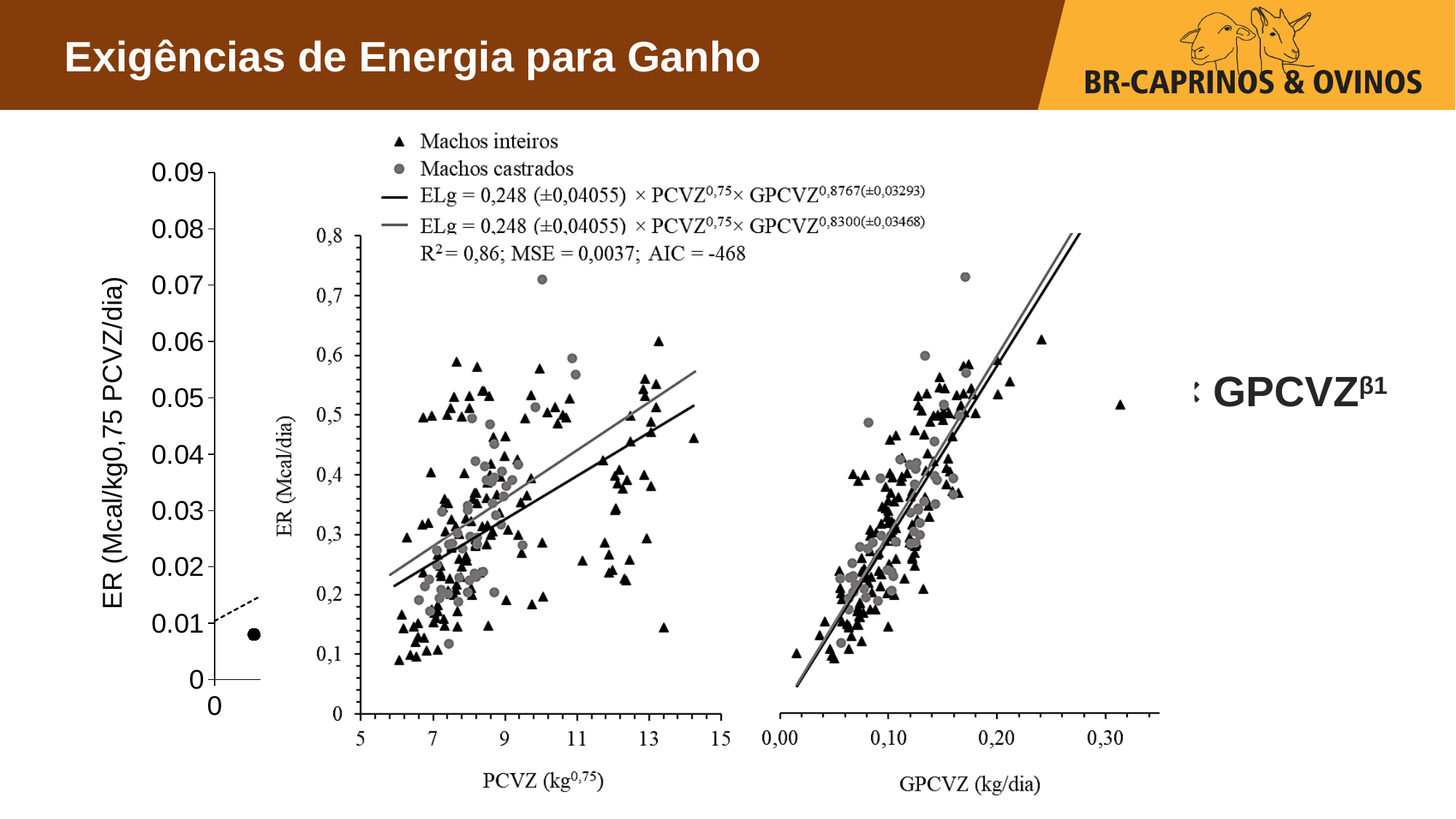
In the left-hand panel (ER vs PCVZ), is the highest Machos castrados point greater or less than 0,7 Mcal/dia? greater In the right-hand panel (ER vs GPCVZ), is the highest plotted point greater or less than 0,7 Mcal/dia? greater What R² value is printed on the scatter chart? 0,86 In the left-hand panel (ER vs PCVZ), is the grey fitted line at PCVZ = 13 greater or less than 0,5 Mcal/dia? greater In the scatter chart, which marker symbol represents Machos inteiros? triangles In the right-hand panel (ER vs GPCVZ), does ER tend to rise or fall as GPCVZ increases? rise In the left-hand panel (ER vs PCVZ), which fitted line is higher at PCVZ = 13, the black line or the grey line? the grey line What is the x-axis label of the right-hand panel of the scatter chart? GPCVZ (kg/dia) Which equation in the legend has the larger exponent on GPCVZ, the black-line equation or the grey-line equation? the black-line equation (0,8767) What kind of chart is shown in the centre of the slide (the two panels with ER on the y axis)? scatter chart In the left-hand panel (ER vs PCVZ), does ER tend to rise or fall as PCVZ increases? rise How many groups of animals does the legend of the scatter chart distinguish with point markers? 2